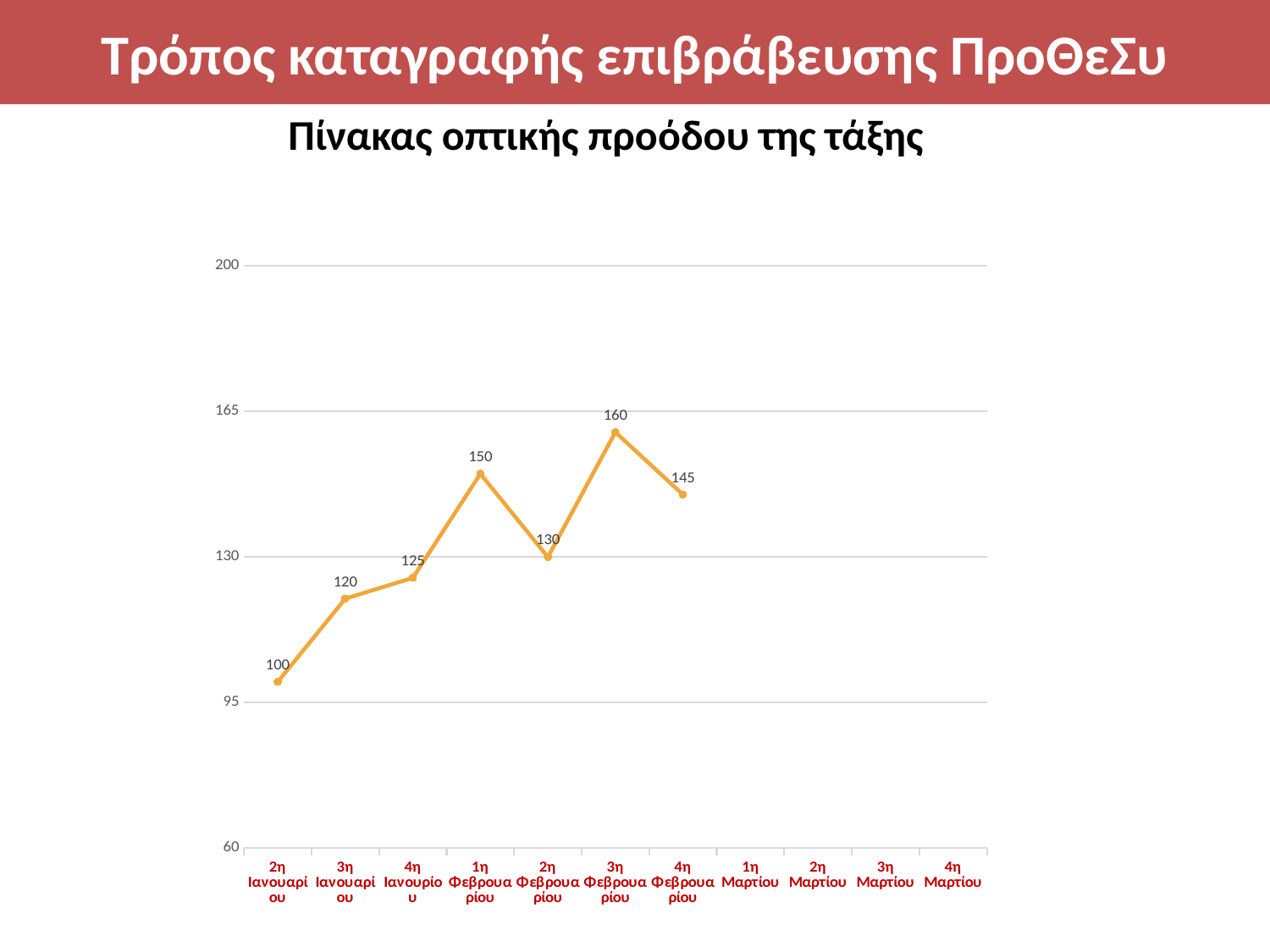
What is the title of the chart? Πίνακας οπτικής προόδου της τάξης How many categories are labelled on the x axis? 11 Which is larger, the value for 1η Φεβρουαρίου or the value for 4η Φεβρουαρίου? 1η Φεβρουαρίου What is the value for 2η Ιανουαρίου? 100 Which week has the highest value? 3η Φεβρουαρίου What is the difference between the values for 3η Φεβρουαρίου and 2η Φεβρουαρίου? 30 What is the value for 1η Φεβρουαρίου? 150 How many data points are plotted on the line? 7 Which week has the lowest value? 2η Ιανουαρίου Is the value for 3η Ιανουαρίου greater or less than 130? less What is the value for 4η Φεβρουαρίου? 145 What kind of chart is shown on the slide? line chart